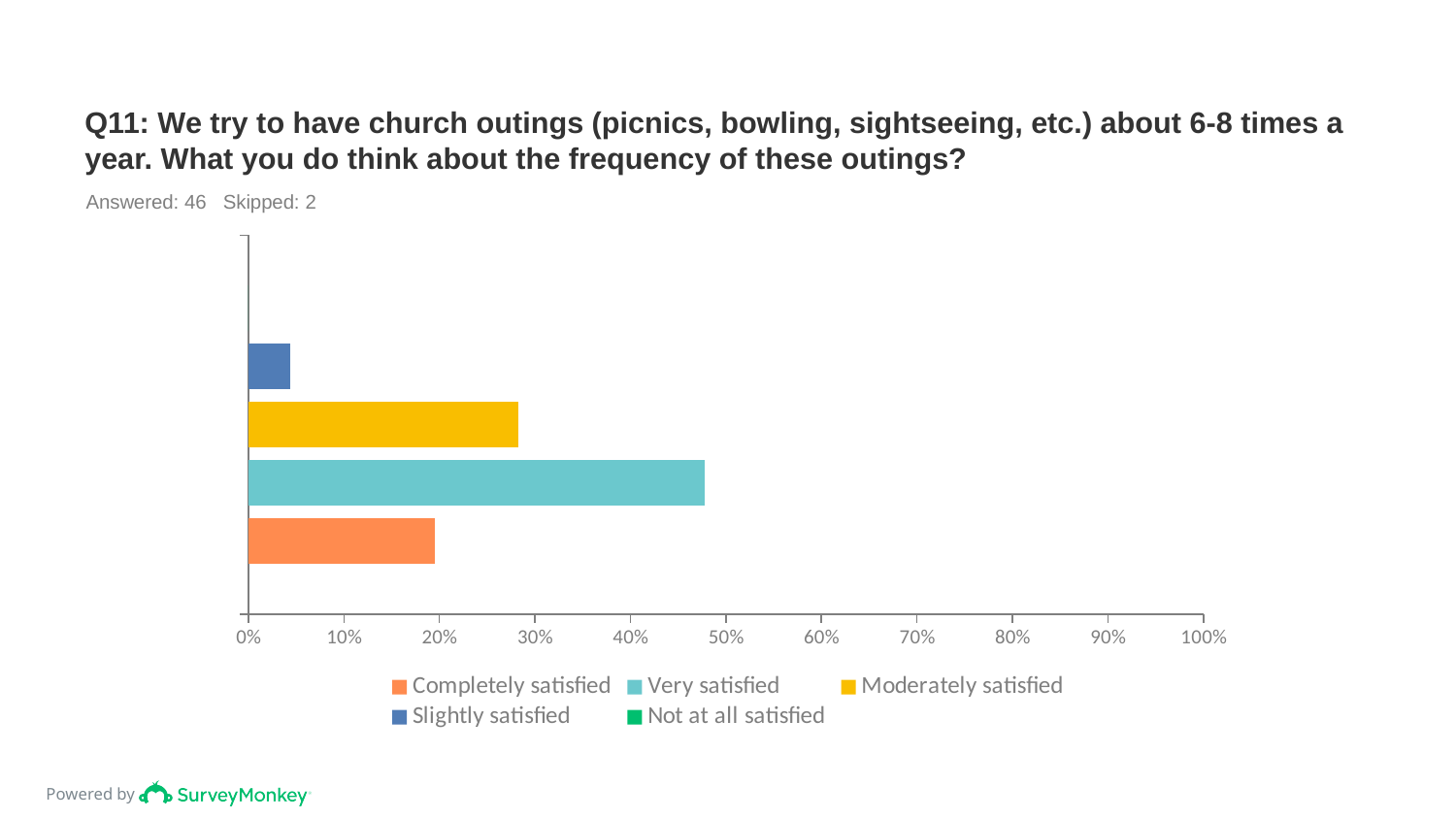
Which response category has the longest bar? Very satisfied Is the value for Completely satisfied greater or less than 30%? less How many respondents answered this question according to the slide? 46 What kind of chart is shown on the slide? bar chart Is the value for Very satisfied greater or less than 40%? greater Which of the visible bars is the shortest? Slightly satisfied Which legend entry has no visible bar in the chart? Not at all satisfied Is the value for Slightly satisfied greater or less than 10%? less How many entries does the legend list? 5 Which is larger, the value for Moderately satisfied or the value for Completely satisfied? Moderately satisfied